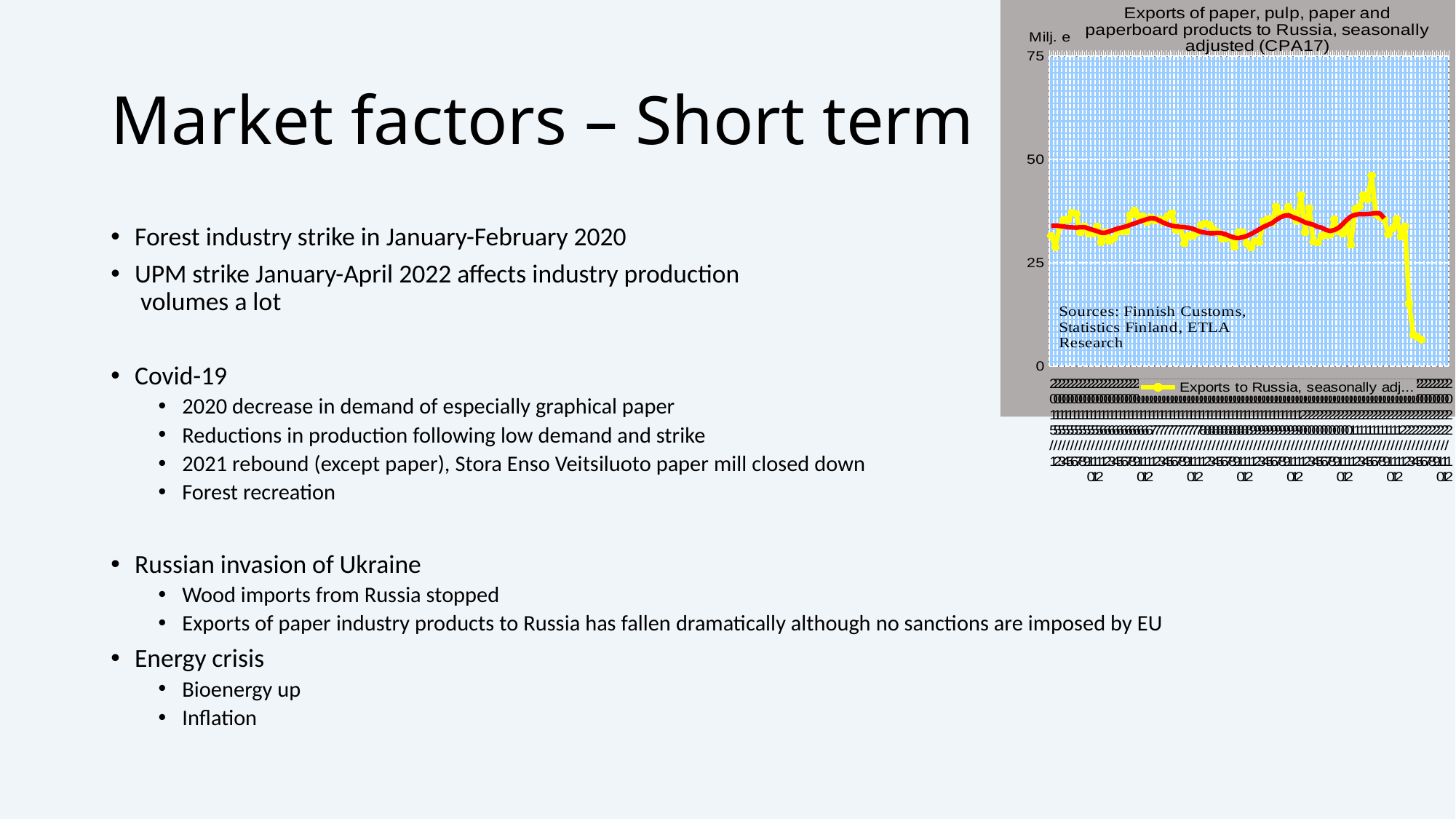
What is the title of the chart on the slide? Exports of paper, pulp, paper and paperboard products to Russia, seasonally adjusted (CPA17) Is the first plotted value of the exports line greater or less than 25? greater What unit is shown on the vertical axis of the chart? Milj. e Does the exports line rise or fall sharply at the right-hand end of the chart? Fall What kind of chart is shown on the slide? Line chart Is the highest peak of the exports line greater or less than 25? greater Is the highest peak of the exports line greater or less than 50? less Which sources are credited on the chart? Finnish Customs, Statistics Finland, ETLA Research What is the highest tick value shown on the vertical axis of the chart? 75